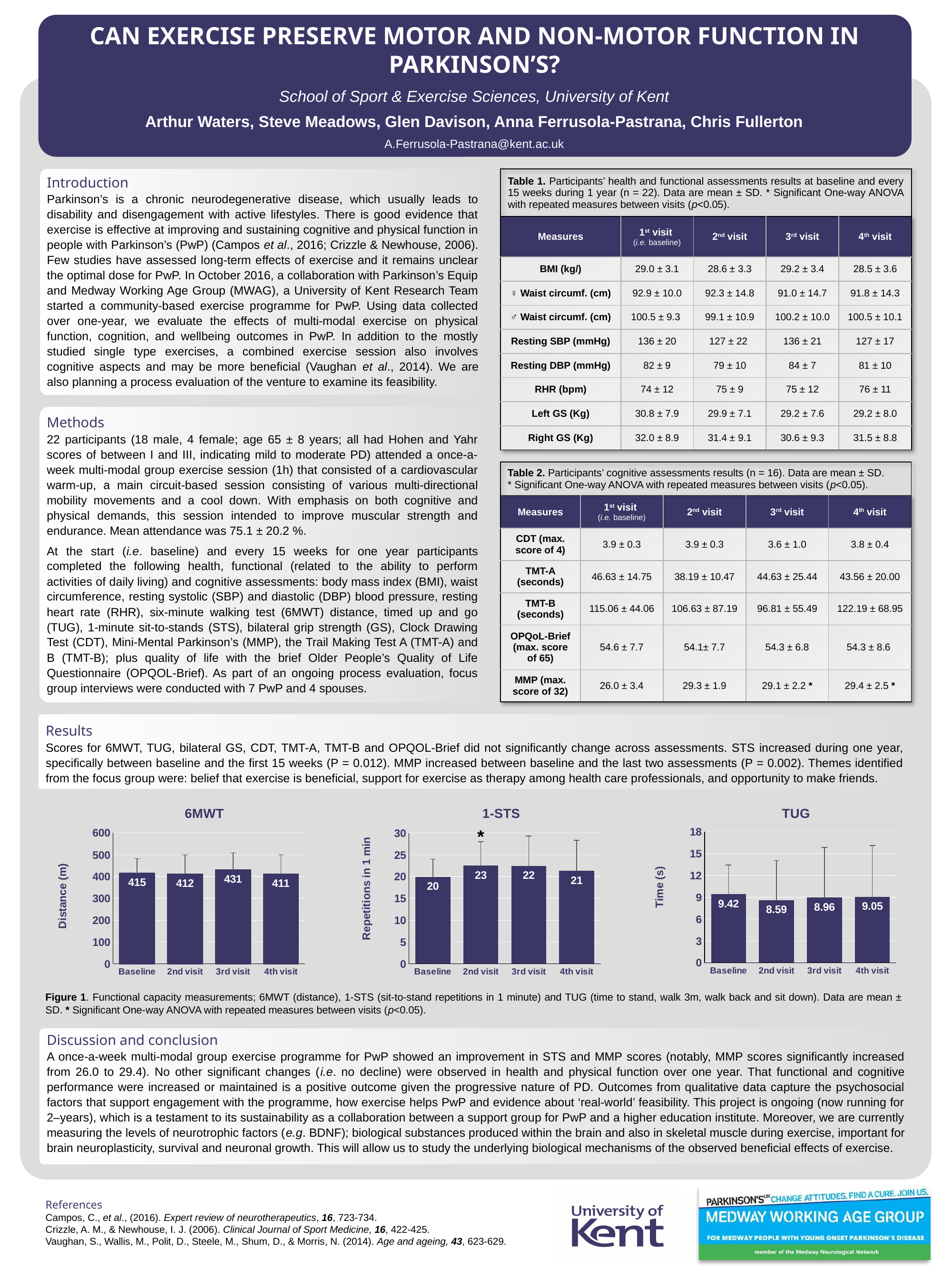
What kind of chart is the 6MWT chart? bar chart In the 6MWT chart, what is the value for the 3rd visit? 431 How many bars are plotted in the TUG chart? 4 In the TUG chart, is the value for the 4th visit larger or smaller than the value for the 3rd visit? larger In the 6MWT chart, what is the difference between the 3rd visit and Baseline values? 16 What is the y-axis label of the 1-STS chart? Repetitions in 1 min In the 1-STS chart, what is the difference between the 2nd visit and Baseline values? 3 In the TUG chart, what is the value for Baseline? 9.42 In the 1-STS chart, which visit has the highest number of repetitions? 2nd visit In the 1-STS chart, what is the value for the 2nd visit? 23 In the TUG chart, which visit has the lowest time? 2nd visit In the 6MWT chart, which visit has the lowest distance? 4th visit